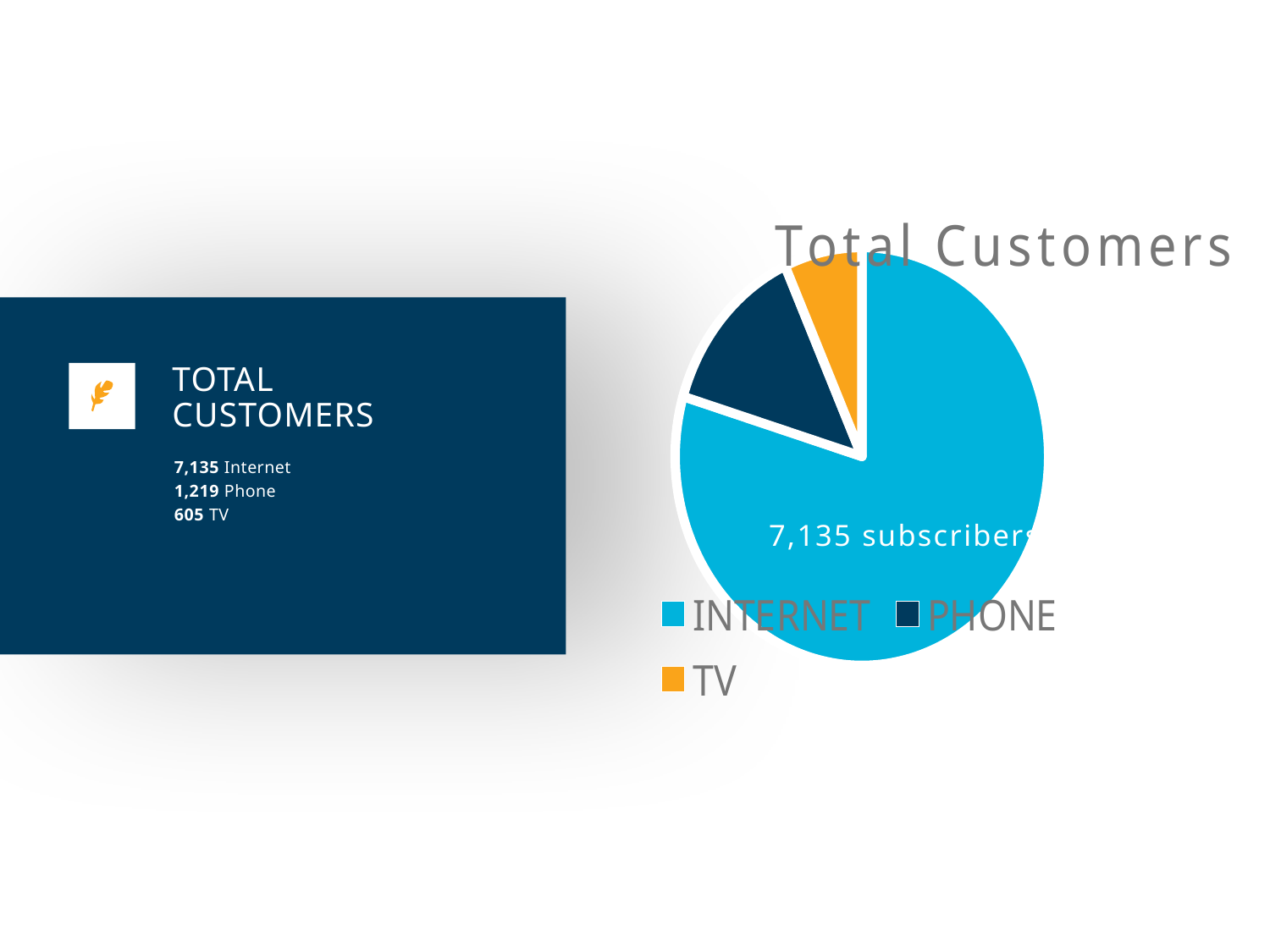
In the Total Customers pie chart, which slice is larger, INTERNET or PHONE? INTERNET Which category has the largest slice in the Total Customers pie chart? INTERNET What colour is the TV slice in the Total Customers pie chart? orange What data label is shown on the INTERNET slice of the Total Customers pie chart? 7,135 subscribers According to the slide, how many Phone customers are there? 1,219 How many entries does the legend of the Total Customers chart list? 3 How many slices does the Total Customers pie chart have? 3 In the Total Customers pie chart, which slice is larger, PHONE or TV? PHONE What is the title of the pie chart? Total Customers According to the slide, how many TV customers are there? 605 Which category has the smallest slice in the Total Customers pie chart? TV What kind of chart is the Total Customers chart? pie chart